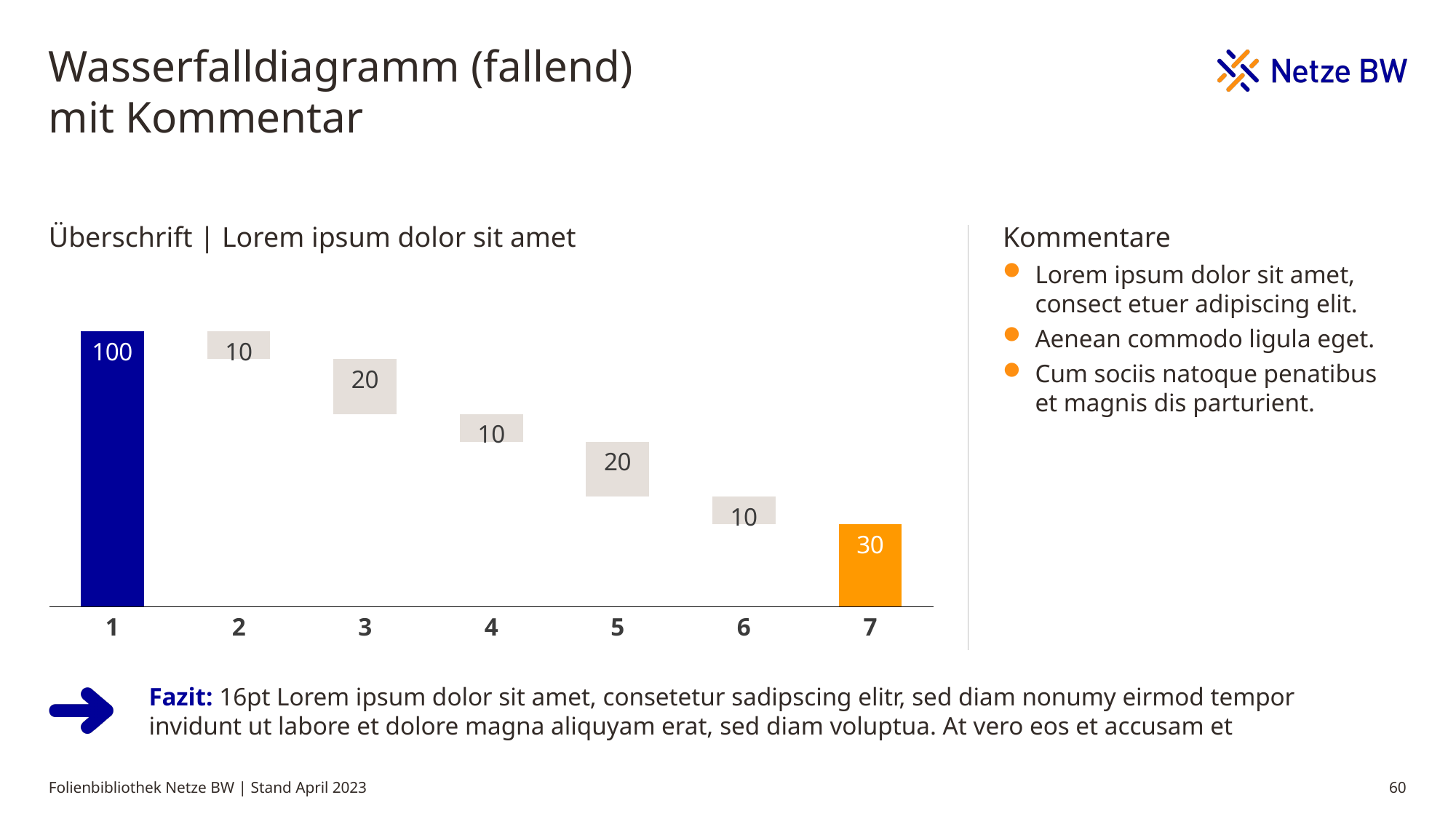
What is the difference between the value for category 1 and the value for category 7? 70 What is the value shown for category 7? 30 How many categories are shown on the x axis? 7 What is the value shown for category 1? 100 Do the bars step downward or upward from category 1 to category 7? downward Which is larger, the value for category 7 or the value for category 5? category 7 What is the value shown for category 6? 10 What is the difference between the value for category 3 and the value for category 2? 10 What is the value shown for category 3? 20 What is the title printed above the chart? Überschrift | Lorem ipsum dolor sit amet What kind of chart is shown on the slide? bar chart (waterfall) Which category has the highest value? 1